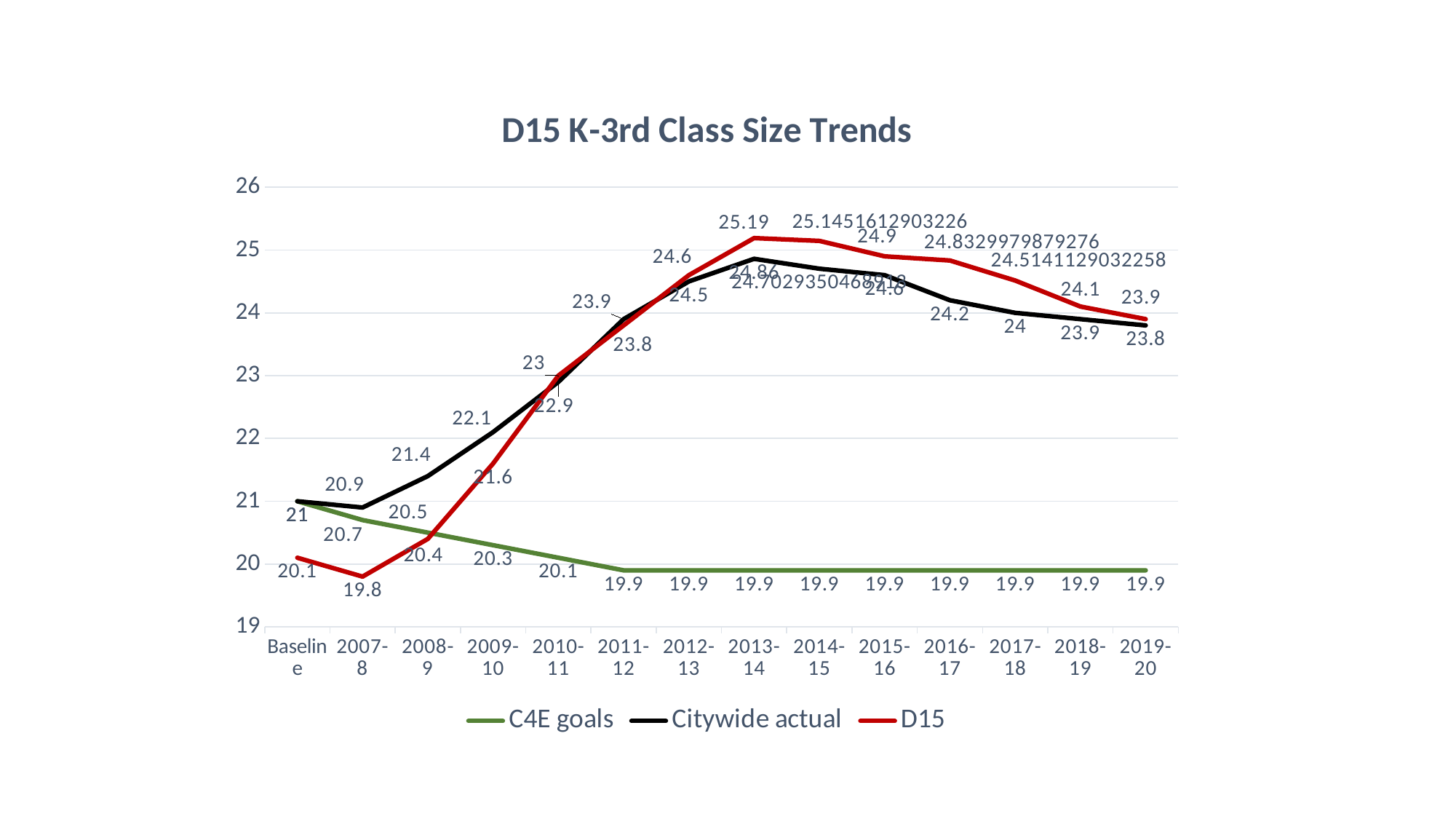
In which year is the D15 series at its highest? 2013-14 Do the C4E goals values rise or fall from Baseline to 2011-12? fall What is the D15 value for 2007-8? 19.8 How many series does the legend list? 3 What is the C4E goals value for 2019-20? 19.9 How many categories are shown on the x axis? 14 What kind of chart is shown on the slide? line chart What is the Citywide actual value for 2012-13? 24.5 In which year is the D15 series at its lowest? 2007-8 In 2009-10, which is larger: Citywide actual or D15? Citywide actual What is the D15 value for 2013-14? 25.19 What is the difference between the D15 value and the Citywide actual value in 2013-14? 0.33